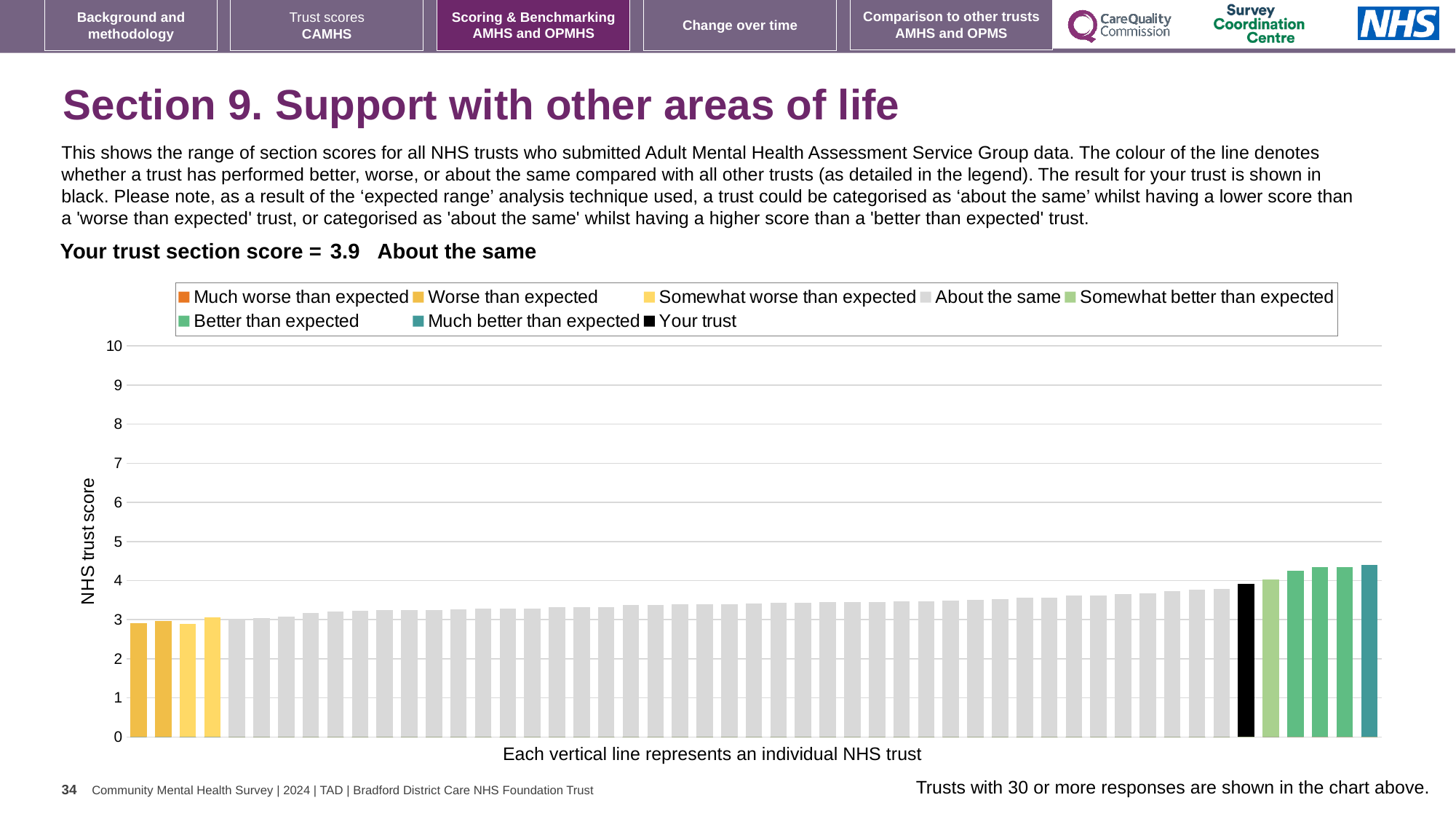
What colour is the bar representing your trust? black What is the label on the y axis of the chart? NHS trust score Is the value for the 'Your trust' bar greater or less than 3? greater Is the value for the 'Your trust' bar greater or less than 5? less Do the bar values rise or fall from left to right along the x axis? rise How many entries does the chart legend list? 8 Is the shortest bar in the chart greater or less than 2? greater Which legend category does the tallest bar belong to? Much better than expected What kind of chart is shown on the slide? bar chart Which is larger: the 'Your trust' bar or the tallest bar in the chart? the tallest bar What is the section score for your trust? 3.9